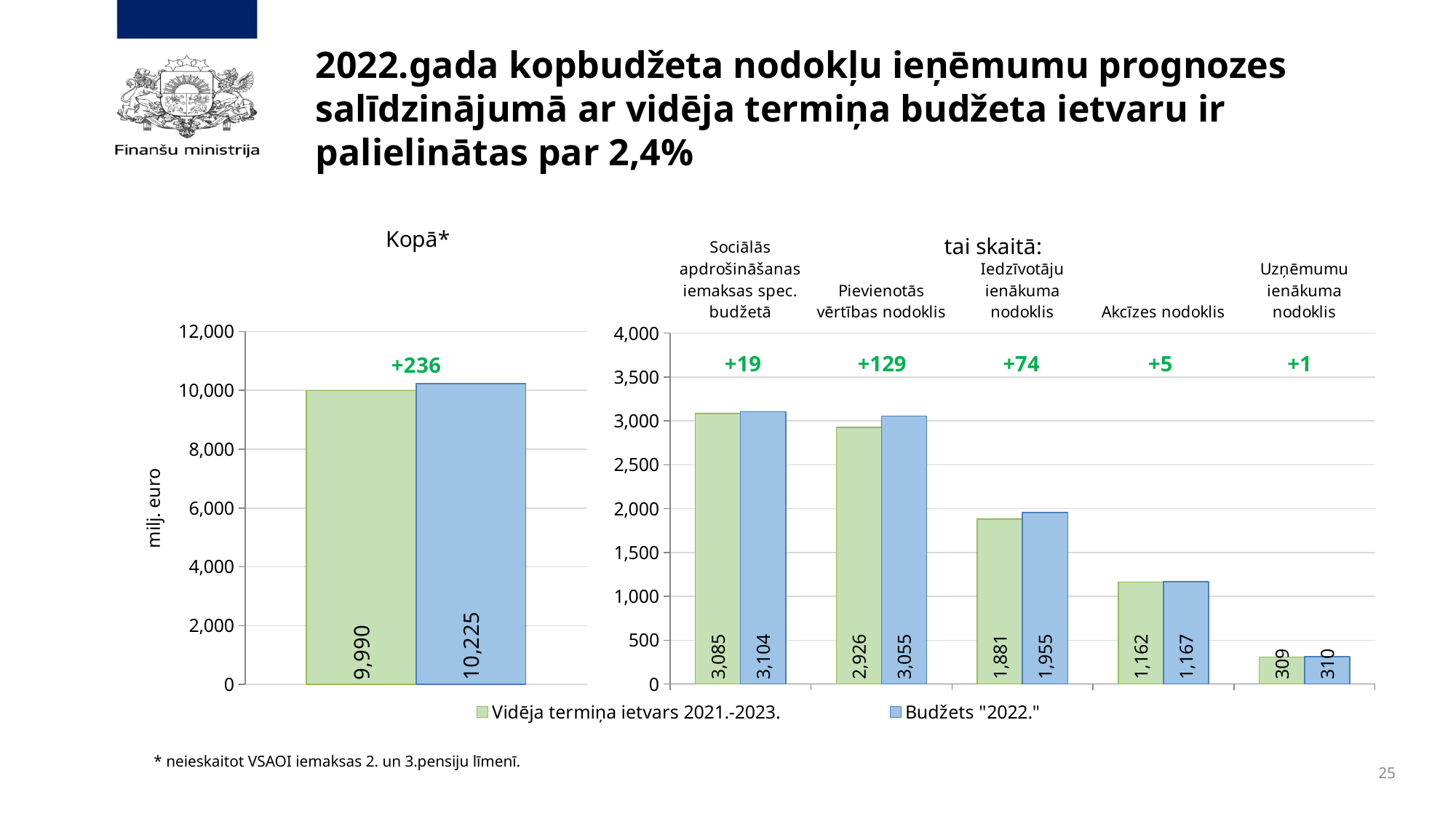
In the left chart titled "Kopā*", what is the value for "Vidēja termiņa ietvars 2021.-2023."? 9,990 In the right chart titled "tai skaitā:", which is larger for Iedzīvotāju ienākuma nodoklis: the "Vidēja termiņa ietvars 2021.-2023." value or the "Budžets "2022."" value? Budžets "2022." In the right chart titled "tai skaitā:", which category has the highest "Budžets "2022."" value? Sociālās apdrošināšanas iemaksas spec. budžetā In the right chart titled "tai skaitā:", which category has the lowest values? Uzņēmumu ienākuma nodoklis In the right chart titled "tai skaitā:", what is the "Vidēja termiņa ietvars 2021.-2023." value for Iedzīvotāju ienākuma nodoklis? 1,881 How many categories are shown in the right chart titled "tai skaitā:"? 5 What kind of chart is the left chart titled "Kopā*"? Bar chart In the right chart titled "tai skaitā:", what is the difference between the two series for Akcīzes nodoklis? 5 How many series does the legend list? 2 In the left chart titled "Kopā*", what is the value for "Budžets "2022.""? 10,225 In the right chart titled "tai skaitā:", what is the "Budžets "2022."" value for Pievienotās vērtības nodoklis? 3,055 In the right chart titled "tai skaitā:", what is the difference between the "Budžets "2022."" and "Vidēja termiņa ietvars 2021.-2023." values for Pievienotās vērtības nodoklis? 129